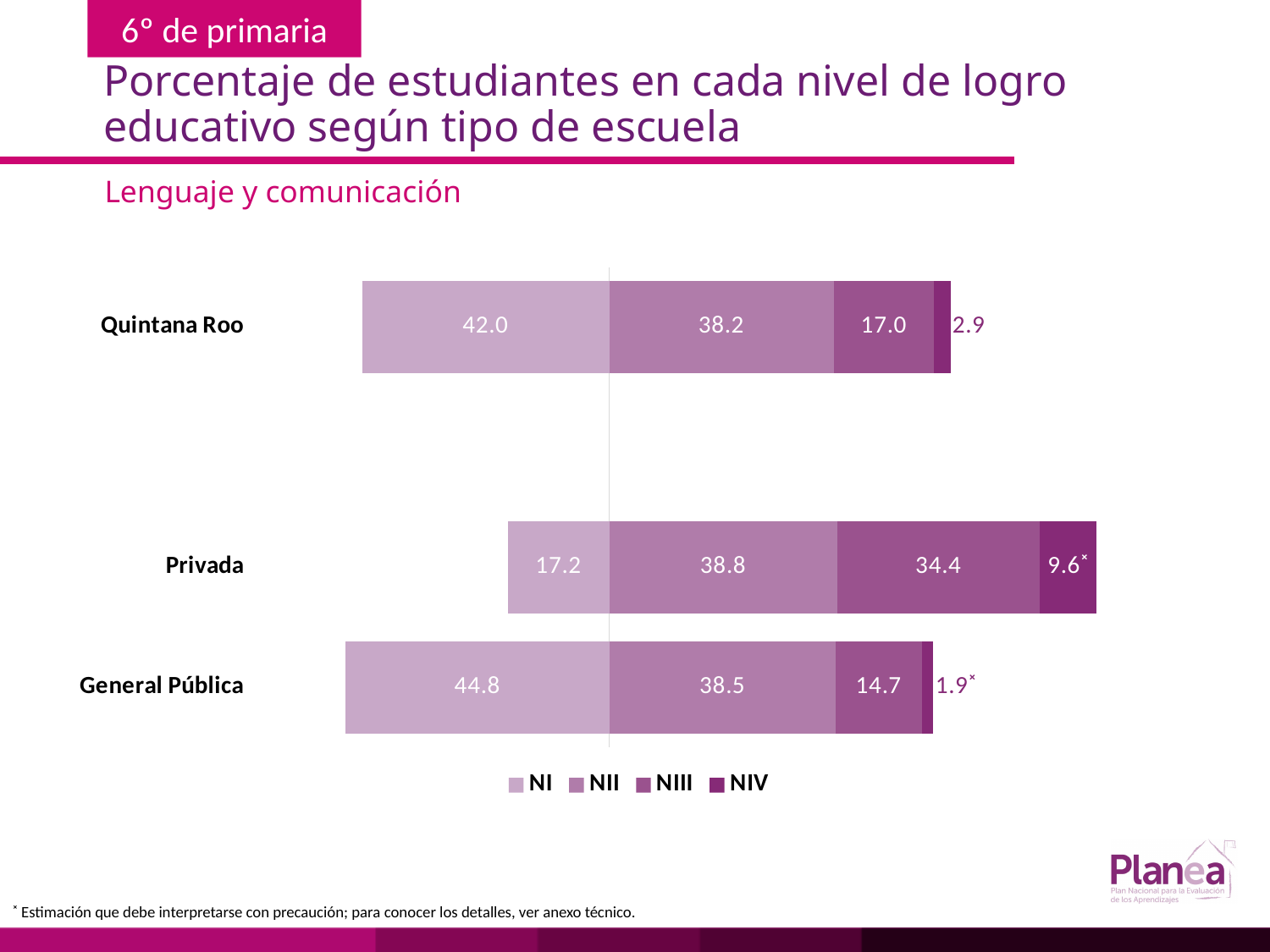
What is the value for NIII for Privada? 34.4 How many categories are shown on the chart? 3 What subject is named in the subtitle above the chart? Lenguaje y comunicación Which category has the lowest value for NIV? General Pública What is the difference between the NIII values for Privada and Quintana Roo? 17.4 What is the total of the stacked bar for Privada? 100.0 How many series does the legend list? 4 What is the value for NIV for General Pública? 1.9 Which category has the highest value for NI? General Pública What is the value for NI for Quintana Roo? 42.0 Which is larger, the NII value for Privada or for General Pública? Privada What kind of chart is shown on the slide? Stacked bar chart